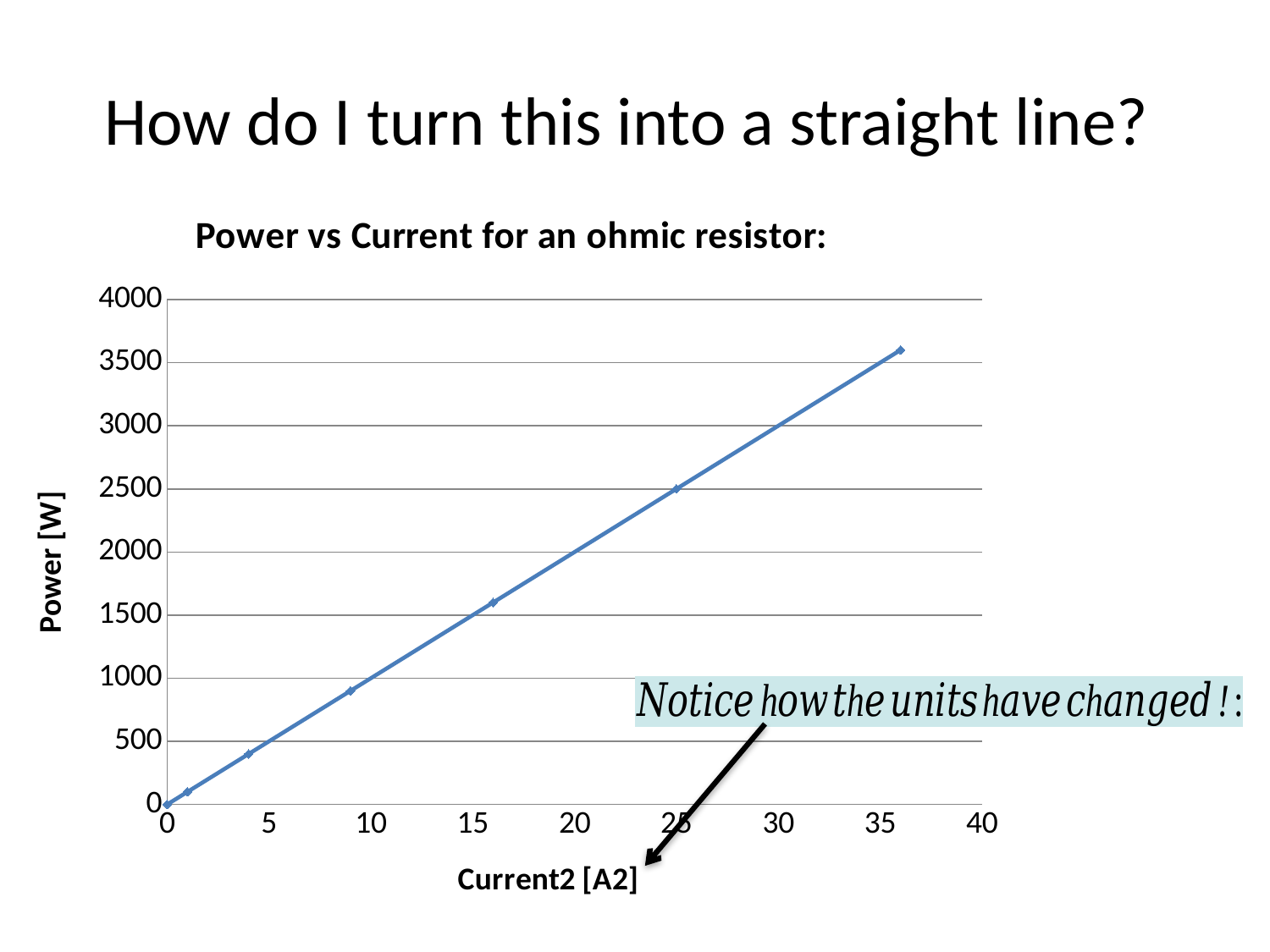
What is the Power value at Current2 = 25? 2500 What is the Power value at Current2 = 0? 0 Is the Power value at Current2 = 9 greater or less than 1000? less Which plotted point has the highest Power value, the one at Current2 = 36 or the one at Current2 = 25? Current2 = 36 Is the Power value at Current2 = 4 greater or less than 500? less What is the label of the y axis? Power [W] Do the plotted values rise or fall as the x axis increases? rise How many data points are plotted on the line? 7 What is the title of the chart? Power vs Current for an ohmic resistor: What kind of chart is shown on the slide? line chart Is the Power value at Current2 = 36 greater or less than 3500? greater